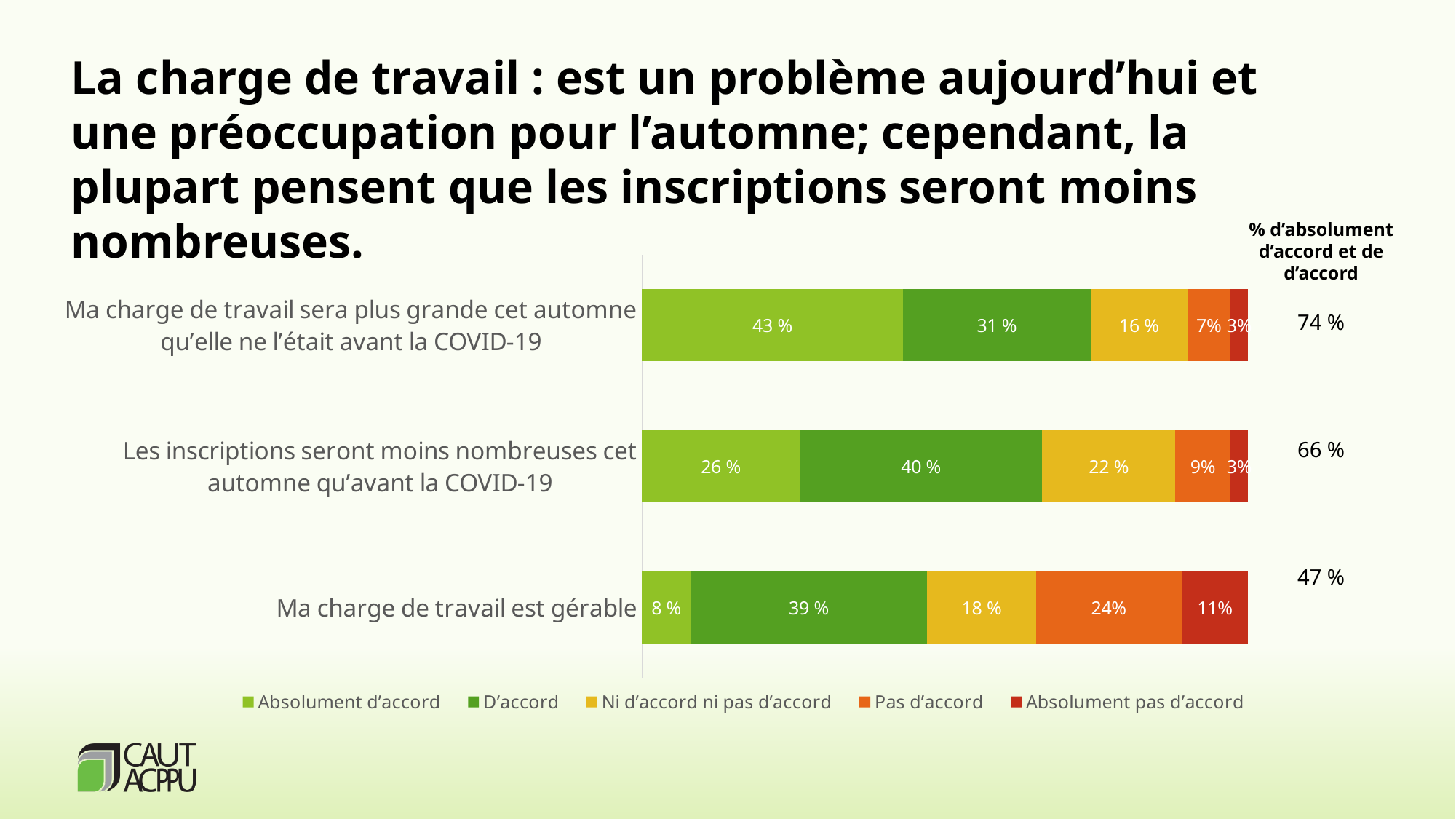
What percentage of respondents are "D'accord" that "Les inscriptions seront moins nombreuses cet automne qu'avant la COVID-19"? 40 % What percentage of respondents are "Absolument d'accord" that "Ma charge de travail sera plus grande cet automne qu'elle ne l'était avant la COVID-19"? 43 % Which is larger: the "Ni d'accord ni pas d'accord" share for "Les inscriptions seront moins nombreuses cet automne qu'avant la COVID-19" or for "Ma charge de travail sera plus grande cet automne qu'elle ne l'était avant la COVID-19"? Les inscriptions seront moins nombreuses cet automne qu'avant la COVID-19 Which statement has the lowest "Absolument d'accord" percentage? Ma charge de travail est gérable What percentage of respondents are "Absolument pas d'accord" that "Ma charge de travail est gérable"? 11% What kind of chart is shown on the slide? Stacked bar chart Which legend entry is shown in the darkest red colour? Absolument pas d'accord What is the difference between the "Pas d'accord" percentage for "Ma charge de travail est gérable" and for "Les inscriptions seront moins nombreuses cet automne qu'avant la COVID-19"? 15 percentage points How many statements (categories) are shown in the chart? 3 What is the combined "% d'absolument d'accord et de d'accord" shown for "Ma charge de travail est gérable"? 47 % How many series does the legend list? 5 Which statement has the highest combined "% d'absolument d'accord et de d'accord"? Ma charge de travail sera plus grande cet automne qu'elle ne l'était avant la COVID-19